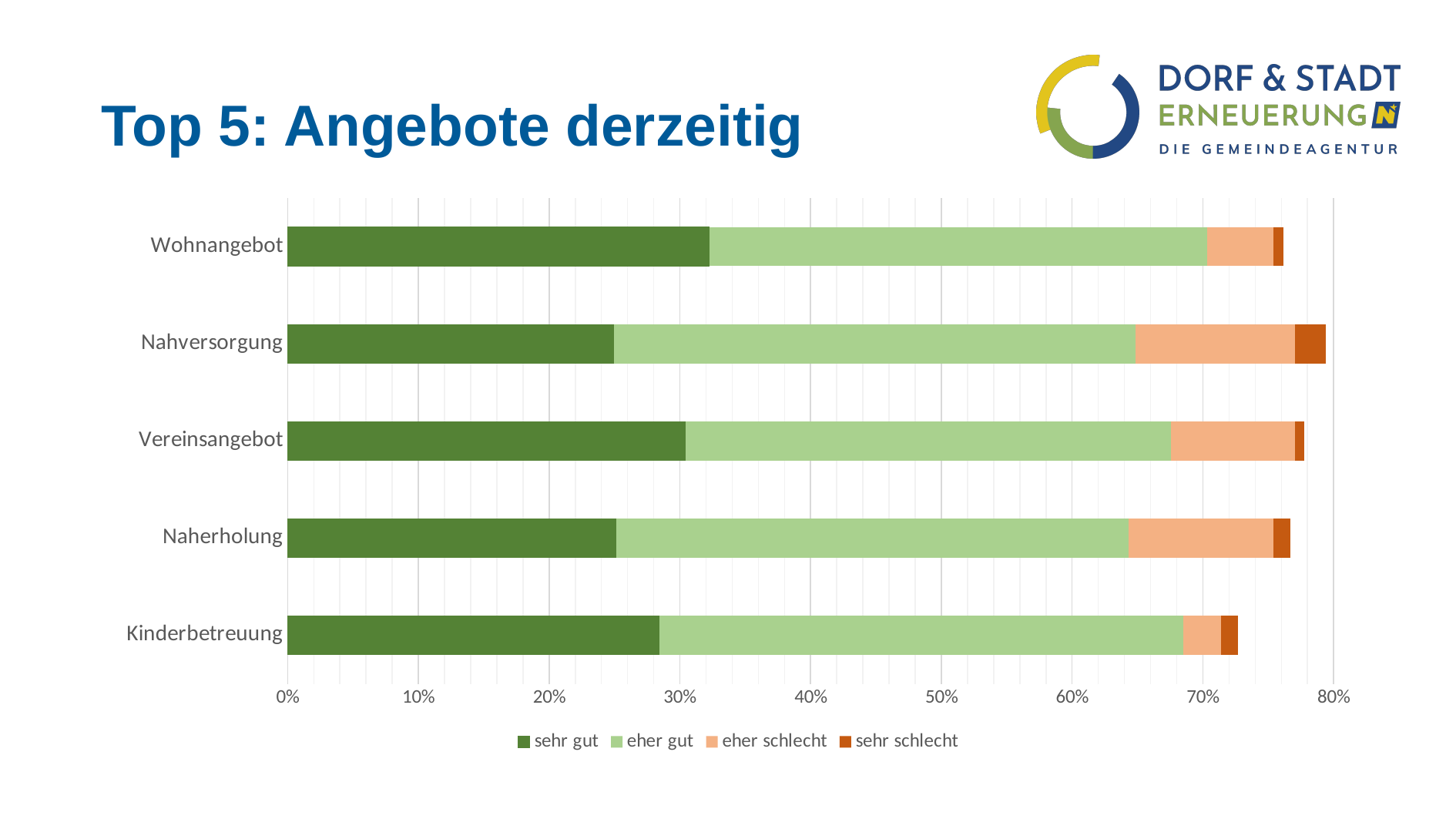
Which category has the shortest total bar? Kinderbetreuung How many series does the legend list? 4 What is the title of the slide? Top 5: Angebote derzeitig Which series is shown in dark green in the legend? sehr gut What kind of chart is shown on the slide? Stacked bar chart Which category has the largest 'sehr gut' segment? Wohnangebot Which has the longer total bar, Kinderbetreuung or Wohnangebot? Wohnangebot How many categories are shown on the chart? 5 Is the total bar length for Kinderbetreuung greater or less than 75%? less Which has the larger 'sehr gut' segment, Wohnangebot or Nahversorgung? Wohnangebot Is the 'sehr gut' value for Nahversorgung greater or less than 30%? less Is the 'sehr gut' value for Wohnangebot greater or less than 30%? greater